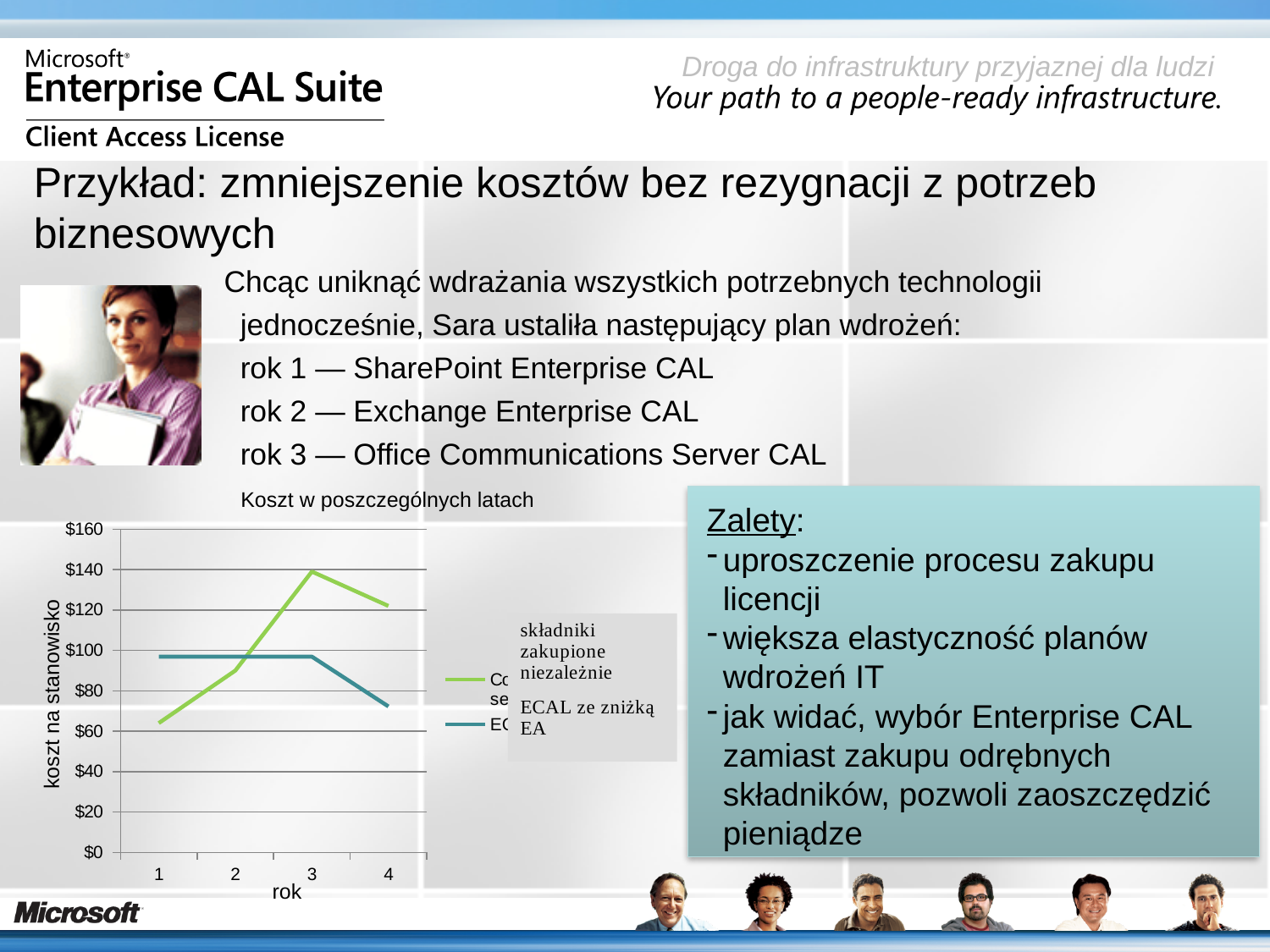
In year 3, which series has the larger value: 'składniki zakupione niezależnie' or 'ECAL ze zniżką EA'? składniki zakupione niezależnie In which year is the value for 'składniki zakupione niezależnie' lowest? 1 Is the value for 'składniki zakupione niezależnie' in year 3 greater or less than $120? greater What is the title of the chart? Koszt w poszczególnych latach Is the value for 'składniki zakupione niezależnie' in year 1 greater or less than $80? less Is the value for 'ECAL ze zniżką EA' in year 4 greater or less than $80? less How many series does the chart's legend list? 2 How many years (points) are plotted along the x axis of the chart? 4 In which year is the value for 'składniki zakupione niezależnie' highest? 3 What is the label of the y axis of the chart? koszt na stanowisko What kind of chart is shown on the slide? line chart Does the value for 'składniki zakupione niezależnie' rise or fall from year 1 to year 3? rise